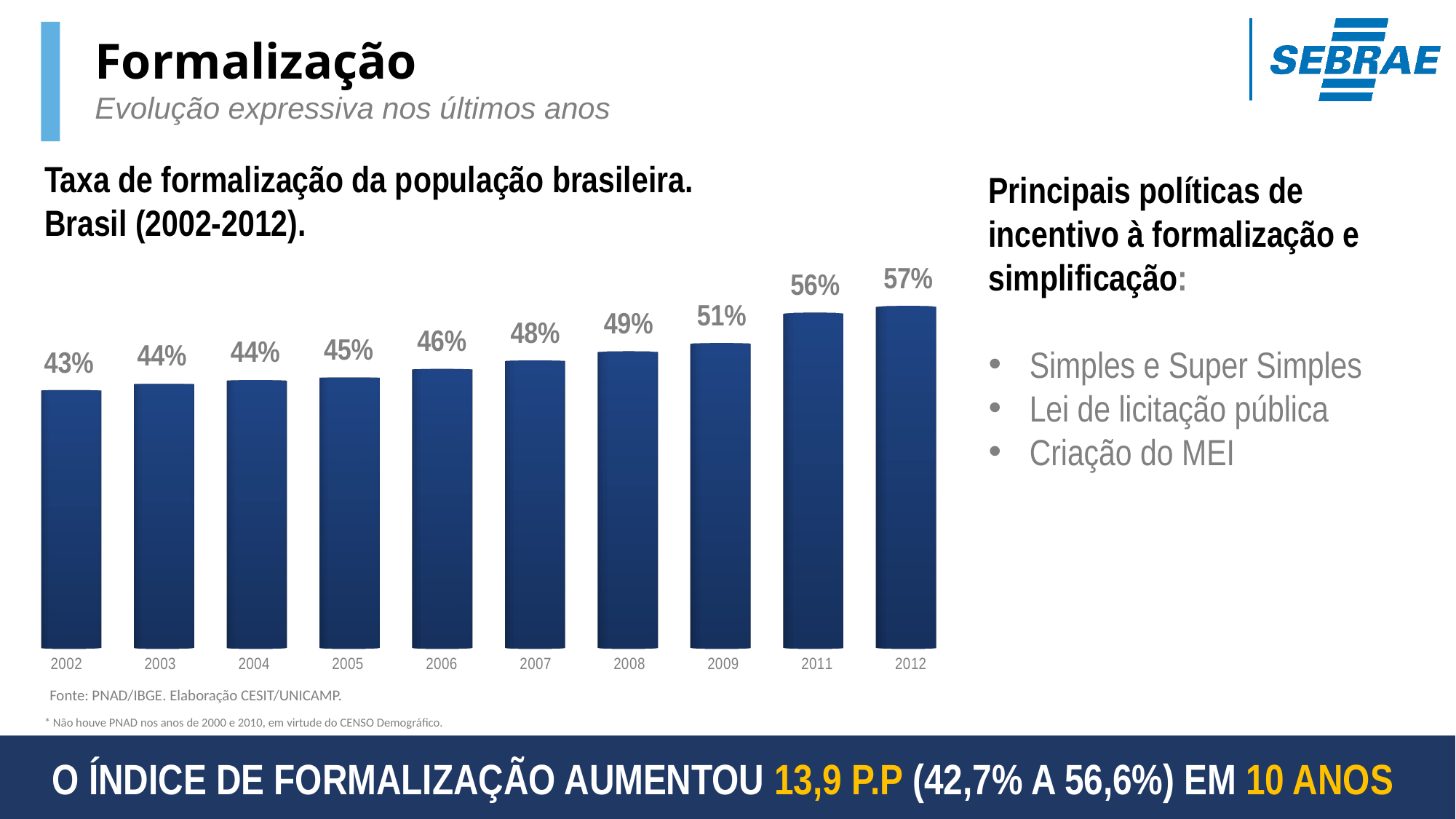
What kind of chart is shown on the slide? Bar chart What is the formalization rate shown for 2011? 56% How many years (bars) are shown in the chart? 10 What is the source cited below the chart? PNAD/IBGE. Elaboração CESIT/UNICAMP. What is the formalization rate shown for 2009? 51% Which year has the lowest formalization rate? 2002 What is the difference in percentage points between the 2012 and 2002 values? 14 Which is larger, the value for 2007 or the value for 2009? 2009 Which year has the highest formalization rate? 2012 Which two consecutive years on the chart show the same value? 2003 and 2004 Do the values rise or fall from 2002 to 2012? Rise What is the formalization rate shown for 2002? 43%